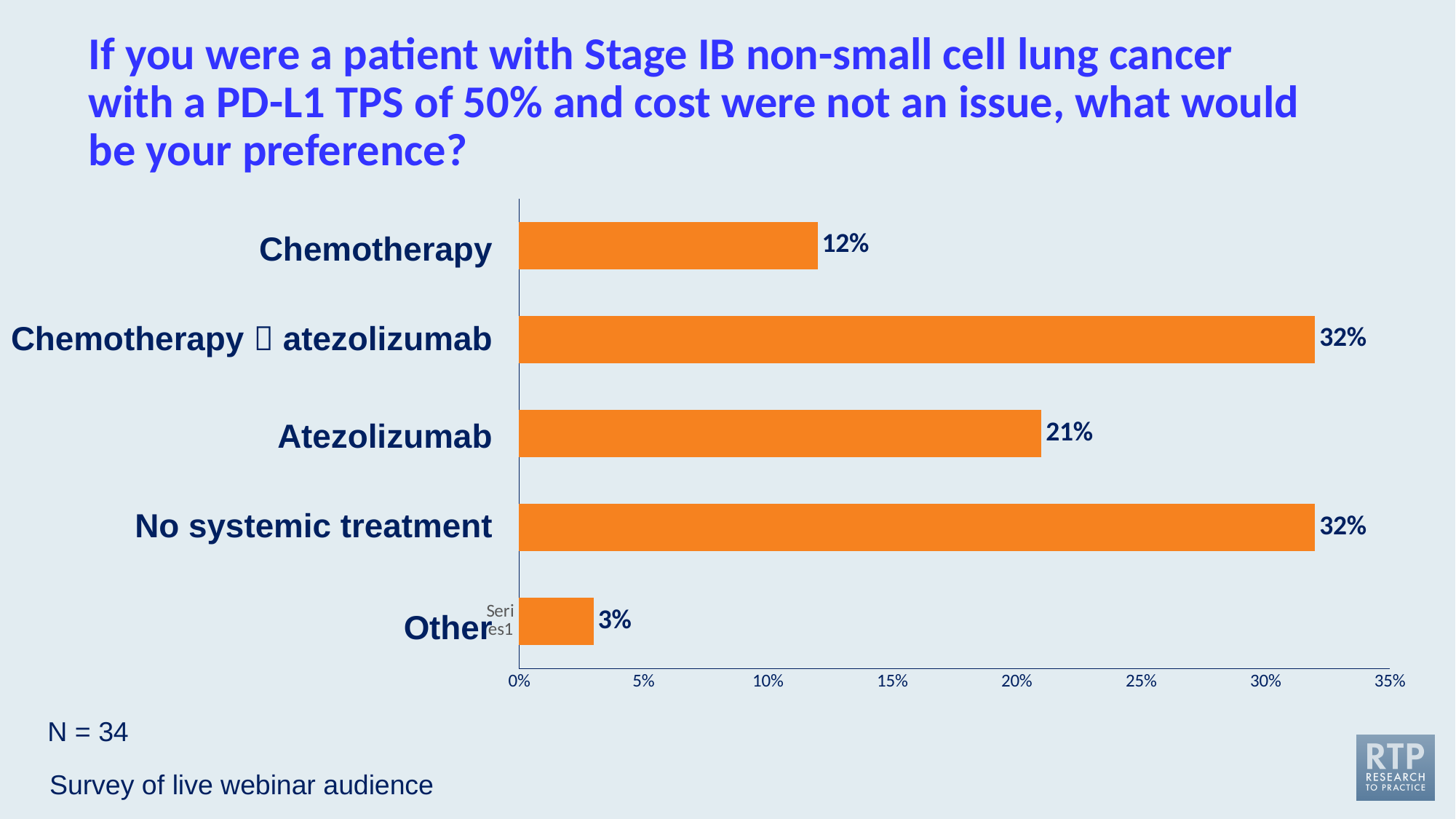
Which option received the lowest percentage of responses? Other What is the difference in percentage points between No systemic treatment and Chemotherapy? 20 What is the difference in percentage points between Atezolizumab and Other? 18 How many response options are shown in the chart? 5 What percentage of respondents chose Chemotherapy? 12% What percentage of respondents chose No systemic treatment? 32% What percentage of respondents chose Atezolizumab? 21% What type of chart is shown on the slide? Bar chart Which received a larger share of responses, Atezolizumab or Chemotherapy? Atezolizumab Is the value for Atezolizumab greater or less than 20%? greater What is the sample size (N) stated on the slide? 34 What percentage of respondents chose Other? 3%